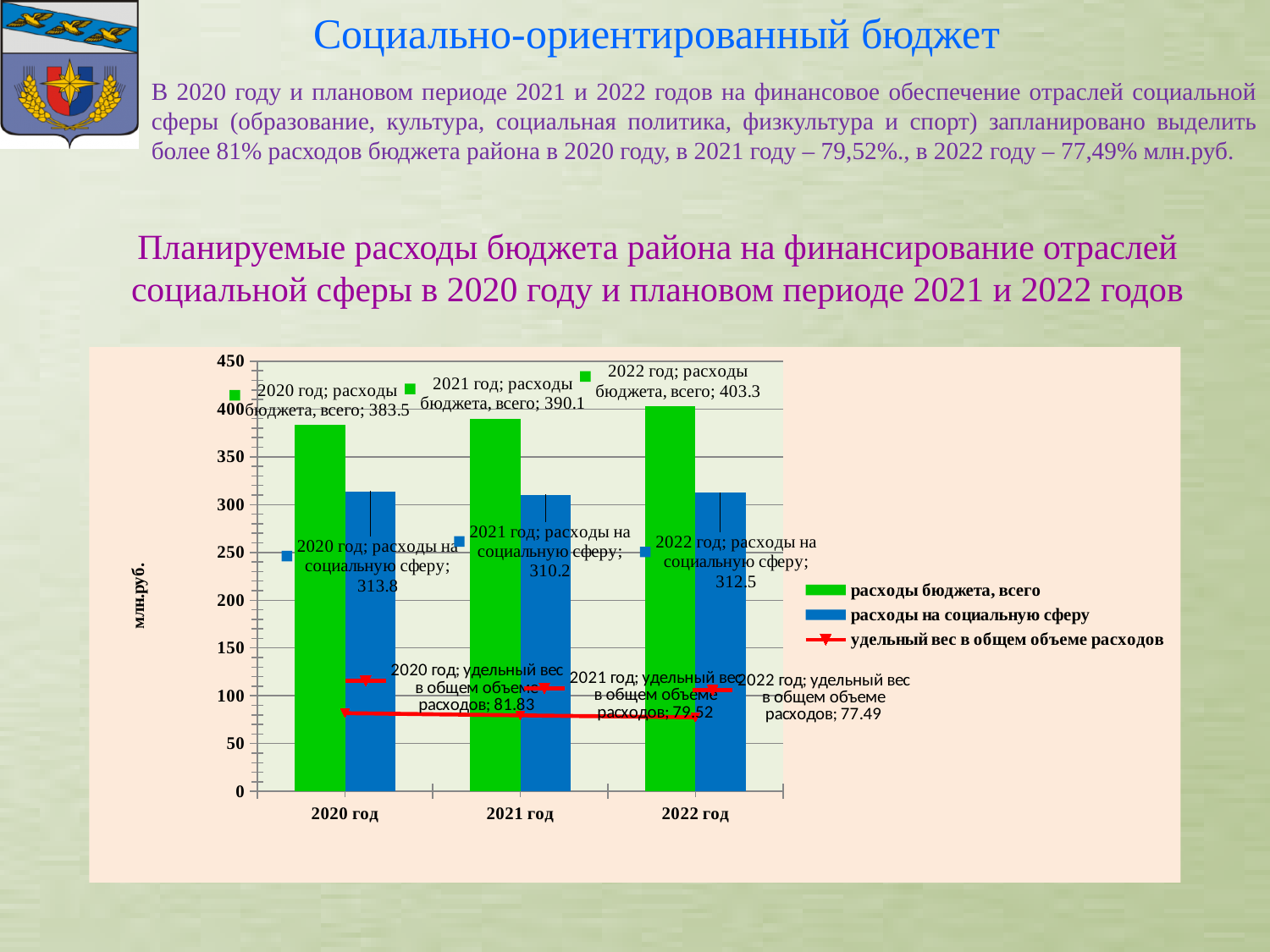
Which year has the lowest value for 'расходы на социальную сферу'? 2021 год What colour are the bars for 'расходы бюджета, всего'? green How many series does the legend list? 3 What is the value of 'расходы на социальную сферу' for 2021 год? 310.2 What is the value of 'расходы бюджета, всего' for 2020 год? 383.5 Which year has the highest value for 'расходы бюджета, всего'? 2022 год What unit is shown on the vertical axis label? млн.руб. Does the value of 'удельный вес в общем объеме расходов' rise or fall from 2020 год to 2022 год? fall What is the difference between 'расходы бюджета, всего' and 'расходы на социальную сферу' in 2022 год? 90.8 How many years (categories) are shown on the x axis? 3 What is the value of 'удельный вес в общем объеме расходов' for 2022 год? 77.49 Which is larger: 'расходы на социальную сферу' in 2020 год or in 2022 год? 2020 год